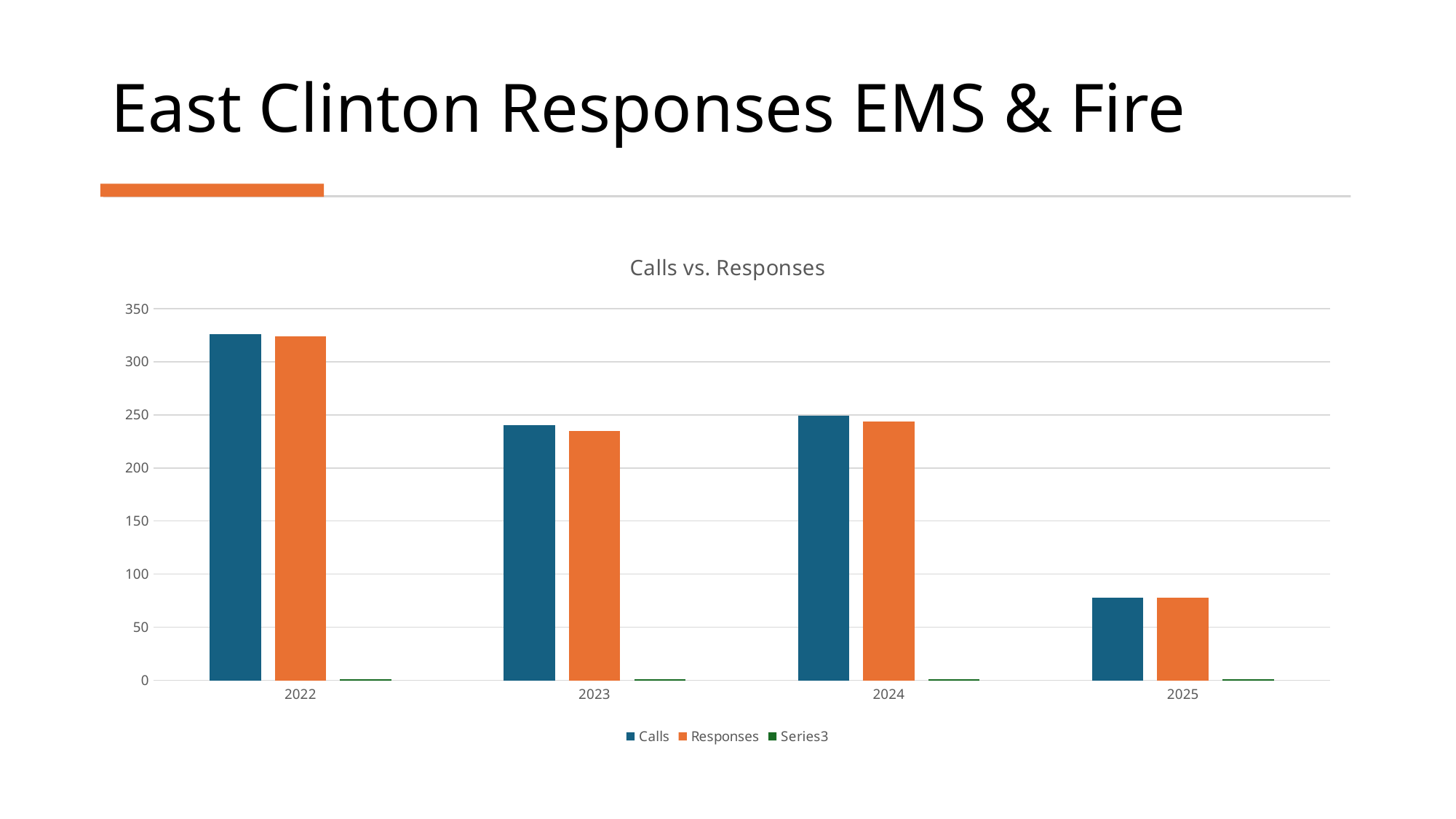
What type of chart is shown on the slide? bar chart Is the value for Calls in 2022 greater or less than 300? greater Which year has the lowest value for Responses? 2025 Is the value for Responses in 2023 greater or less than 200? greater How many years are shown on the x axis? 4 Is the value for Calls in 2025 greater or less than 100? less How many series does the legend list? 3 Do the Calls values rise or fall from 2024 to 2025? fall What colour are the Responses bars? orange What is the title of the chart? Calls vs. Responses Which is larger, Calls in 2022 or Calls in 2023? Calls in 2022 Which year has the highest value for Calls? 2022